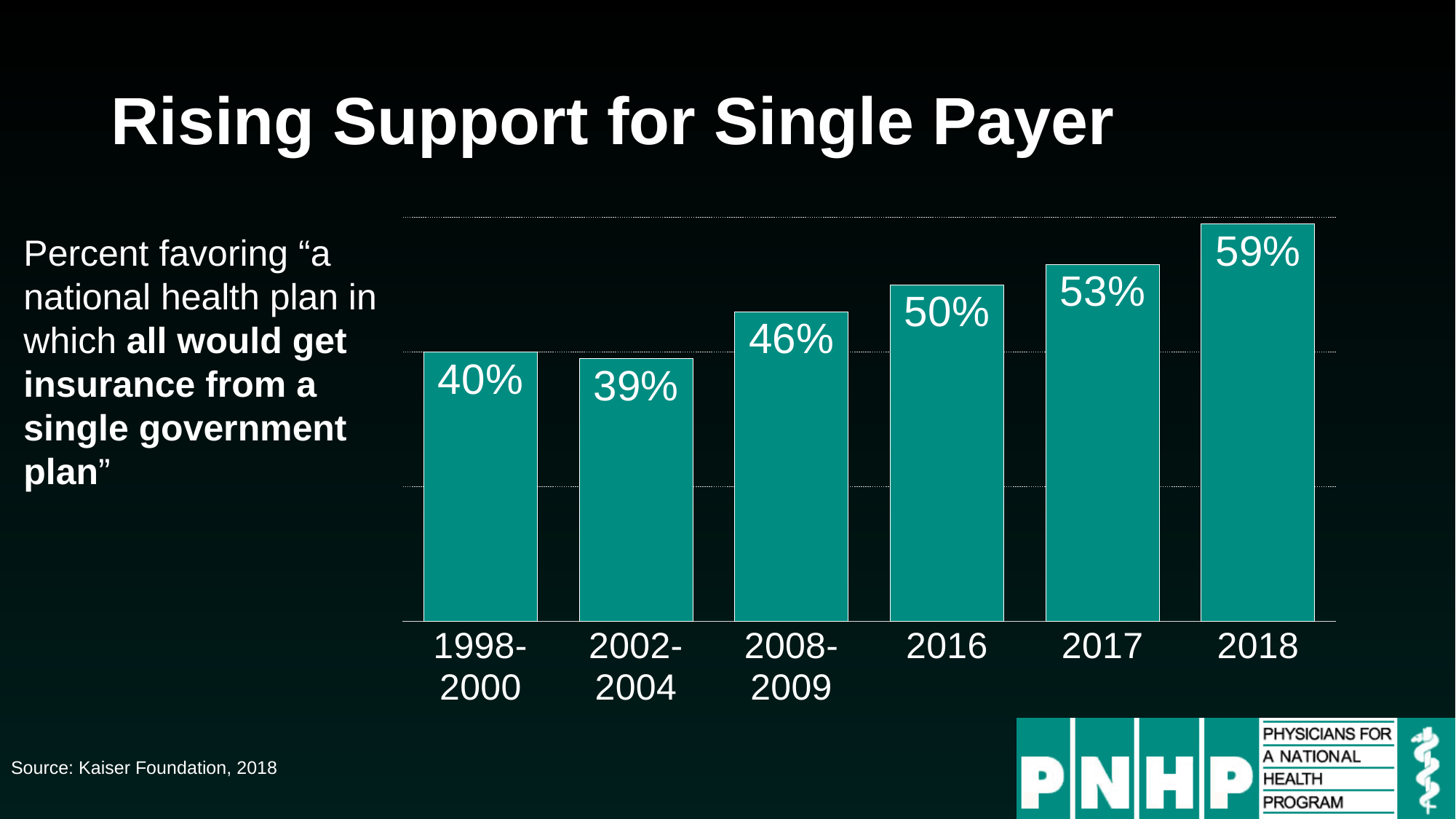
Do the values generally rise or fall from 2002-2004 to 2018? Rise What is the difference between the 2017 value and the 2016 value? 3% What kind of chart is shown on the slide? Bar chart What is the difference between the 2018 value and the 1998-2000 value? 19% Which period has the lowest value? 2002-2004 Which period has the highest value? 2018 What percent favored single payer in 2018? 59% What is the value shown for 2002-2004? 39% What is the value shown for 2008-2009? 46% What is the title of the slide containing the chart? Rising Support for Single Payer Which is larger, the value for 2016 or the value for 2008-2009? 2016 How many periods are shown on the x axis? 6